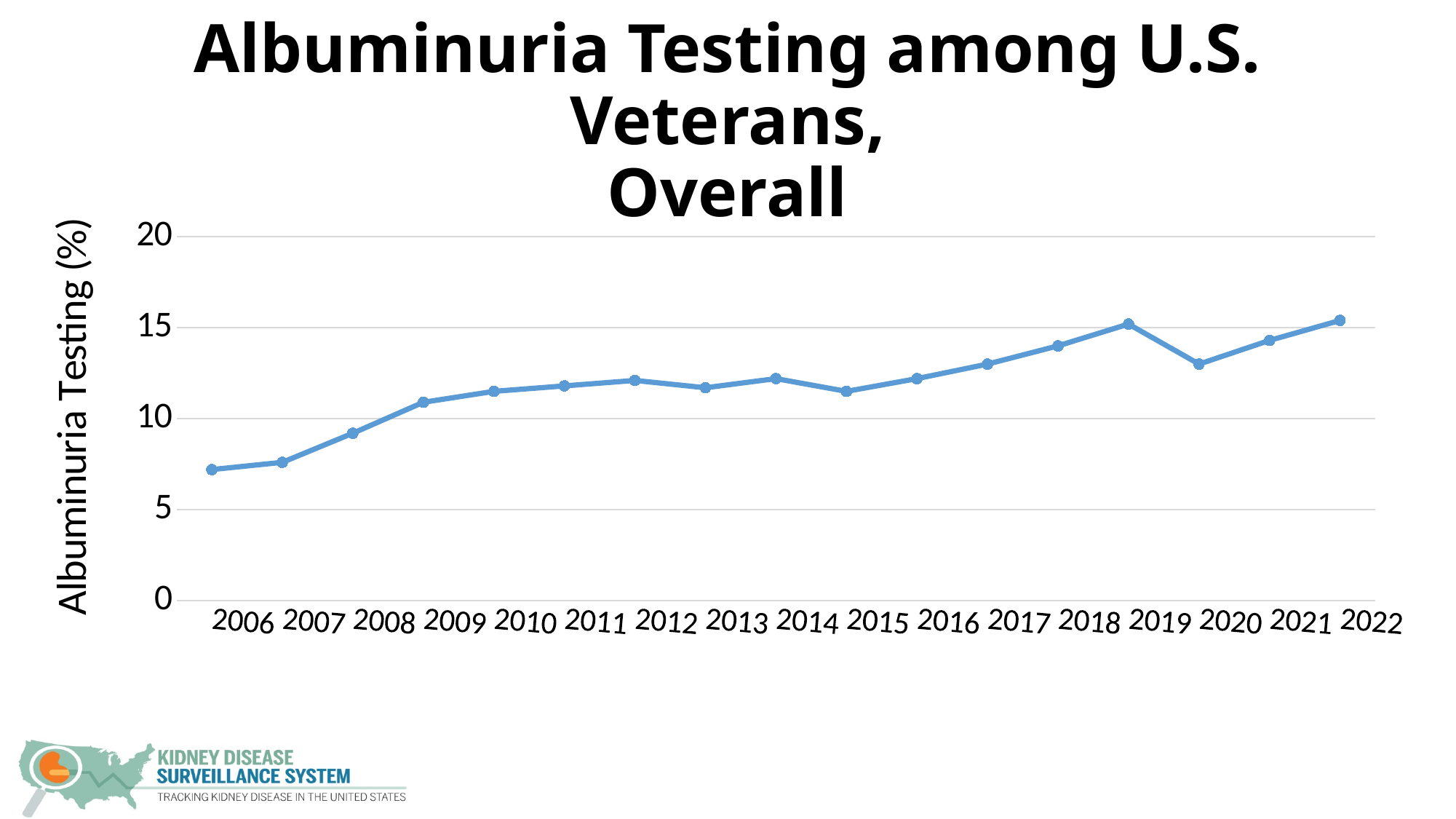
Is the value for 2020 greater or less than 10? greater What is the label of the y axis? Albuminuria Testing (%) Is the value for 2015 greater or less than 15? less Which year has the larger value, 2006 or 2018? 2018 What is the title of the chart? Albuminuria Testing among U.S. Veterans, Overall Which year has the lowest albuminuria testing percentage? 2006 Which year has the larger value, 2019 or 2020? 2019 How many years are plotted on the x axis? 17 Is the value for 2006 greater or less than 10? less Overall, do the values rise or fall from 2006 to 2022? rise What kind of chart is shown on the slide? line chart